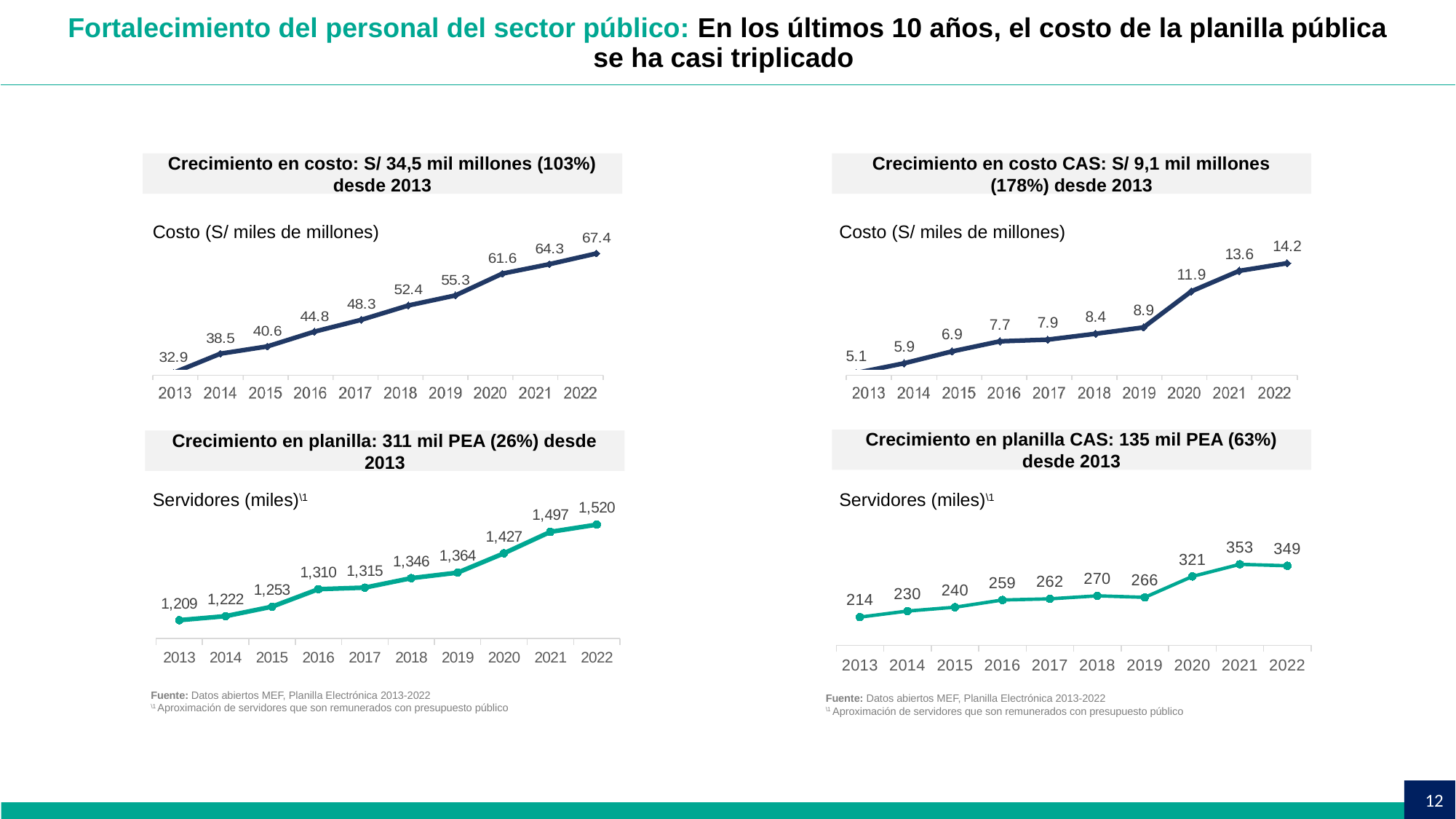
In the top-right chart (Crecimiento en costo CAS), which year has the lowest value? 2013 In the top-left chart (Crecimiento en costo: S/ 34,5 mil millones), what is the cost value for 2013? 32.9 In the bottom-left chart (Crecimiento en planilla: 311 mil PEA), which year has the highest value? 2022 What kind of chart is the bottom-left chart (Crecimiento en planilla: 311 mil PEA)? Line chart In the bottom-left chart (Crecimiento en planilla: 311 mil PEA), what is the value for 2019? 1,364 How many years are plotted in the top-right chart (Crecimiento en costo CAS)? 10 In the bottom-right chart (Crecimiento en planilla CAS), which is larger, the value for 2018 or the value for 2019? 2018 In the top-right chart (Crecimiento en costo CAS), what is the value for 2020? 11.9 In the top-left chart (Crecimiento en costo: S/ 34,5 mil millones), what is the cost value for 2022? 67.4 In the bottom-right chart (Crecimiento en planilla CAS), which year has the highest value? 2021 In the bottom-right chart (Crecimiento en planilla CAS), what is the difference between the 2022 value and the 2013 value? 135 In the top-left chart (Crecimiento en costo: S/ 34,5 mil millones), what is the difference between the 2022 value and the 2021 value? 3.1